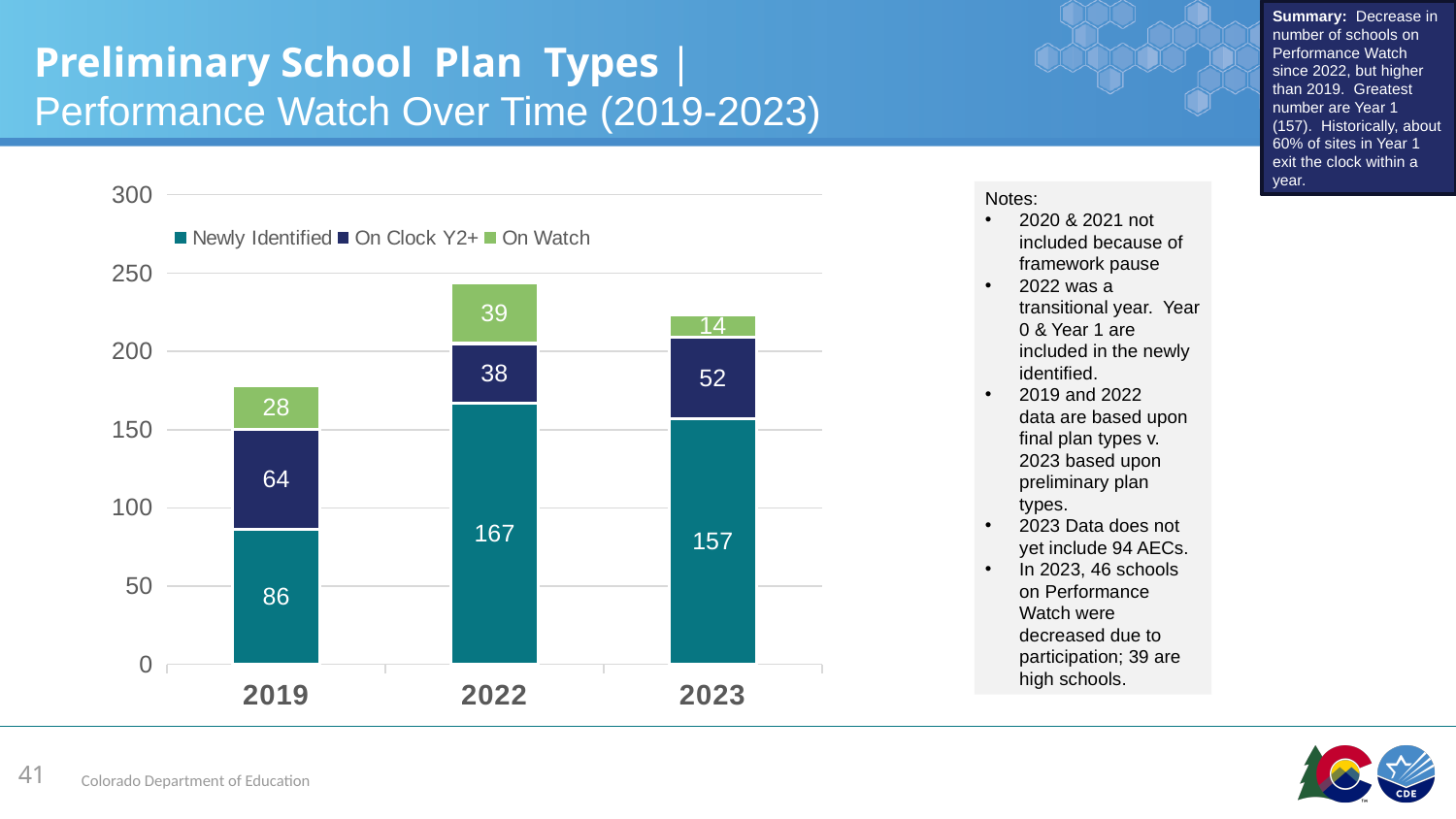
What is the Newly Identified value for 2022? 167 What type of chart is shown on the slide? Stacked bar chart How many years are shown on the x axis? 3 What is the total of the stacked bar for 2019? 178 Which is larger, the On Clock Y2+ value for 2023 or for 2022? 2023 What is the difference between the Newly Identified values for 2022 and 2023? 10 What is the On Clock Y2+ value for 2019? 64 Which year has the lowest On Watch value? 2023 What is the On Watch value for 2023? 14 How many series does the legend list? 3 Which year has the highest Newly Identified value? 2022 Which series is shown in green in the legend? On Watch